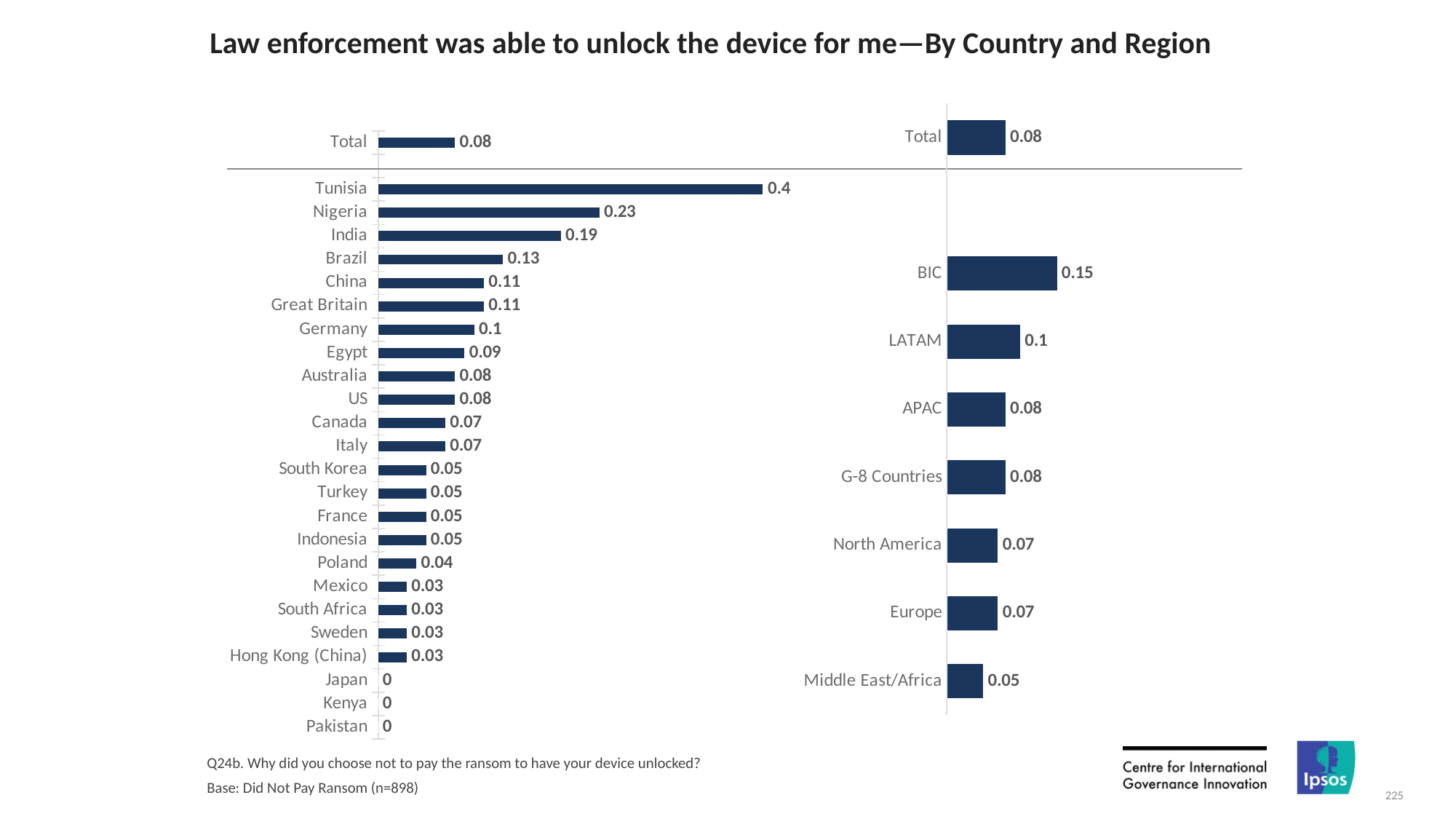
In the left chart (by country), what is the value for Tunisia? 0.4 In the left chart (by country), which is larger, the value for Germany or the value for Egypt? Germany In the right chart (by region), what is the difference between the values for BIC and LATAM? 0.05 In the left chart (by country), how many countries are listed below the Total bar? 24 In the right chart (by region), what is the value for BIC? 0.15 In the left chart (by country), what is the value for Poland? 0.04 In the left chart (by country), what is the difference between the values for India and Brazil? 0.06 What type of chart is used on this slide? Bar chart In the right chart (by region), which region has the lowest value? Middle East/Africa In the left chart (by country), which country has the highest value? Tunisia In the left chart (by country), what is the value for Nigeria? 0.23 In the right chart (by region), how many regions are listed below the Total bar? 7